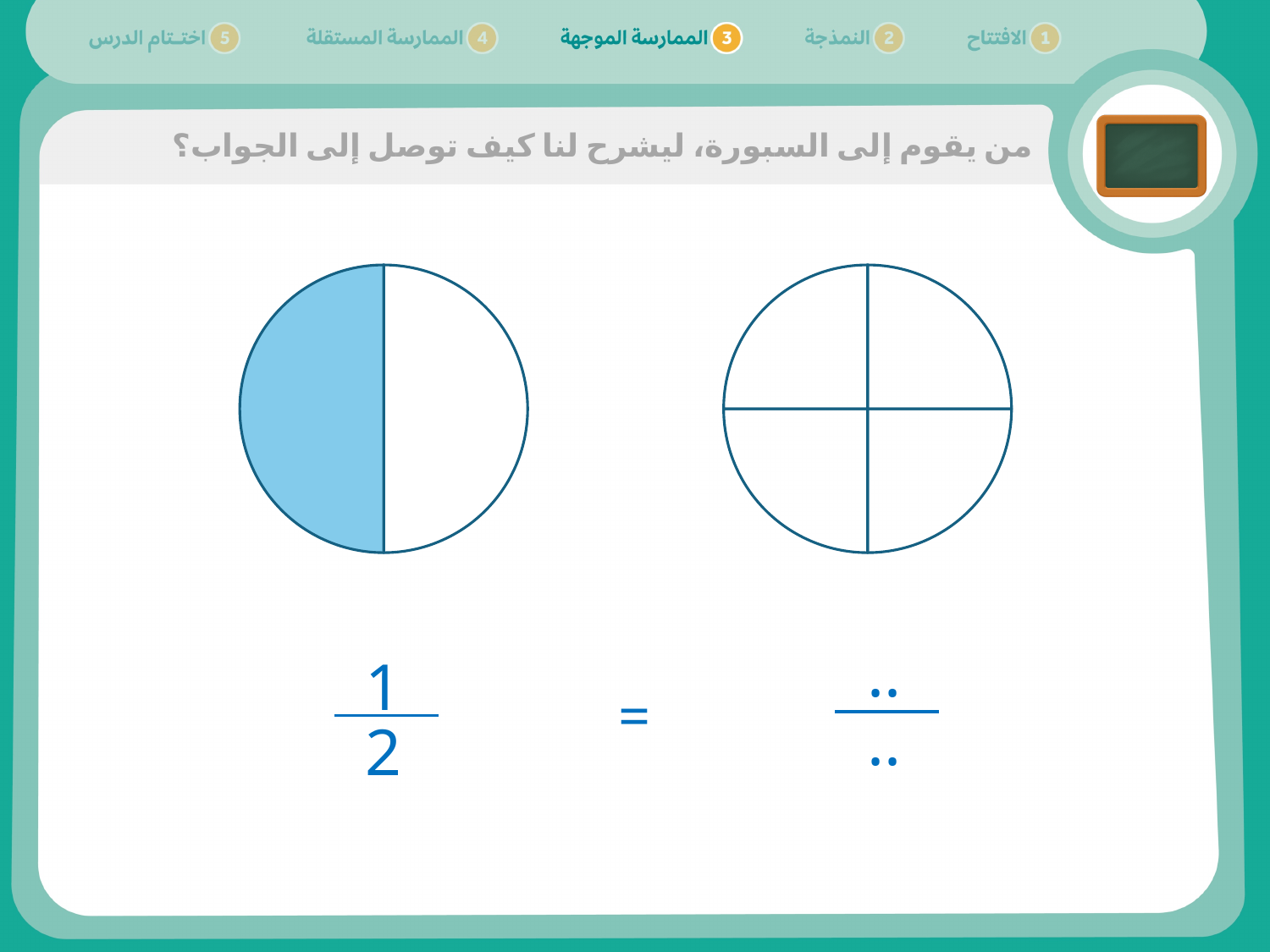
How many parts of the left circle are shaded? 1 What colour is the shaded part of the left circle? blue Into how many equal parts is the left circle divided? 2 What fraction of the left circle is shaded, as written on the slide? 1/2 What fraction is written below the left circle? 1/2 How many circle diagrams are shown on the slide? 2 Which circle, left or right, has a shaded region? left